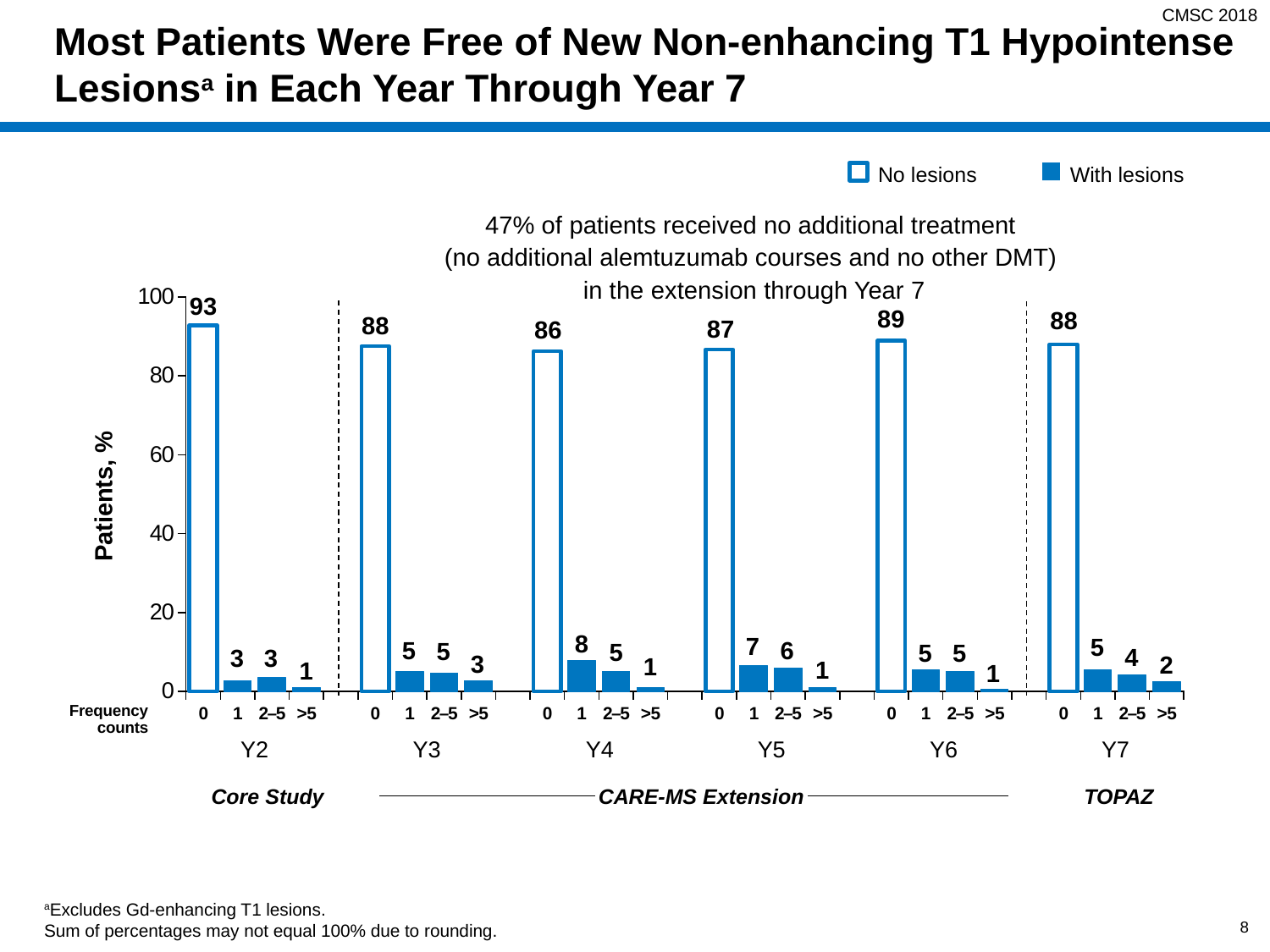
Which is larger: the percentage of patients with 1 lesion in Y4 or in Y5? Y4 What is the difference between the percentage of patients with no lesions in Y2 and in Y4? 7 What is the label of the y axis? Patients, % Is the percentage of patients with no lesions in Y6 greater or less than 80? greater What type of chart is shown on the slide? Bar chart In which year was the percentage of patients with no lesions (frequency count 0) highest? Y2 In which year was the percentage of patients with no lesions (frequency count 0) lowest? Y4 What percentage of patients had a frequency count of >5 lesions in Y7? 2 How many series does the legend list? 2 What percentage of patients had a frequency count of 2–5 lesions in Y5? 6 What percentage of patients had no new non-enhancing T1 hypointense lesions (frequency count 0) in Y2? 93 What percentage of patients had a frequency count of 1 lesion in Y4? 8